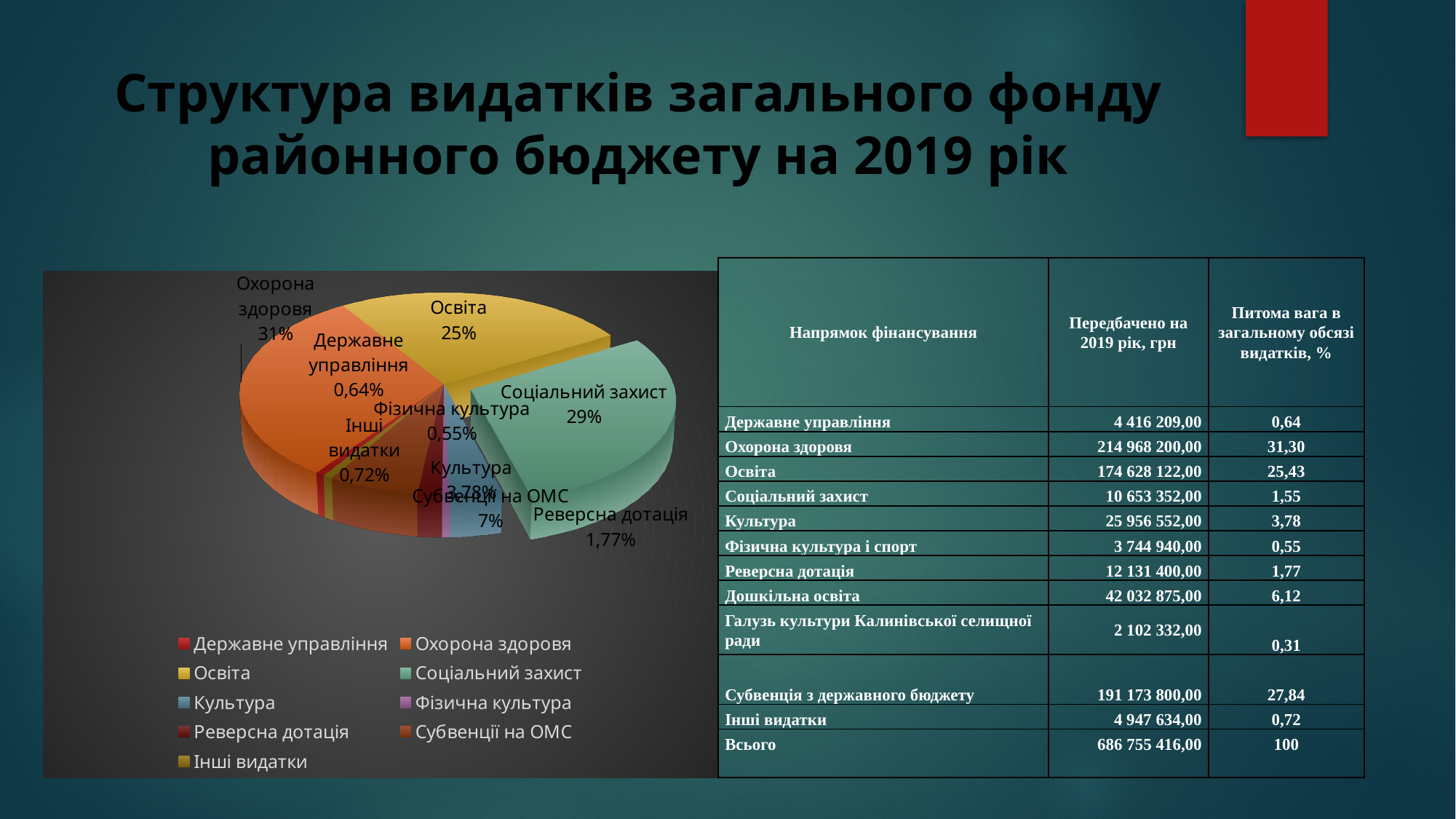
Which slice of the pie chart has the largest labelled share? Охорона здоровя How many entries does the pie chart's legend list? 9 In the pie chart, what share is labelled for Охорона здоровя? 31% Which slice of the pie chart has the smallest labelled share? Фізична культура In the pie chart, what is the difference between the labelled shares of Освіта and Субвенції на ОМС? 18% What kind of chart is shown on the left of the slide? pie chart In the pie chart, which is larger: Освіта or Соціальний захист? Соціальний захист In the pie chart, what share is labelled for Культура? 3,78% In the pie chart, what share is labelled for Освіта? 25% In the pie chart, what share is labelled for Субвенції на ОМС? 7% In the pie chart's legend, which category is shown in yellow? Освіта In the pie chart, what share is labelled for Реверсна дотація? 1,77%